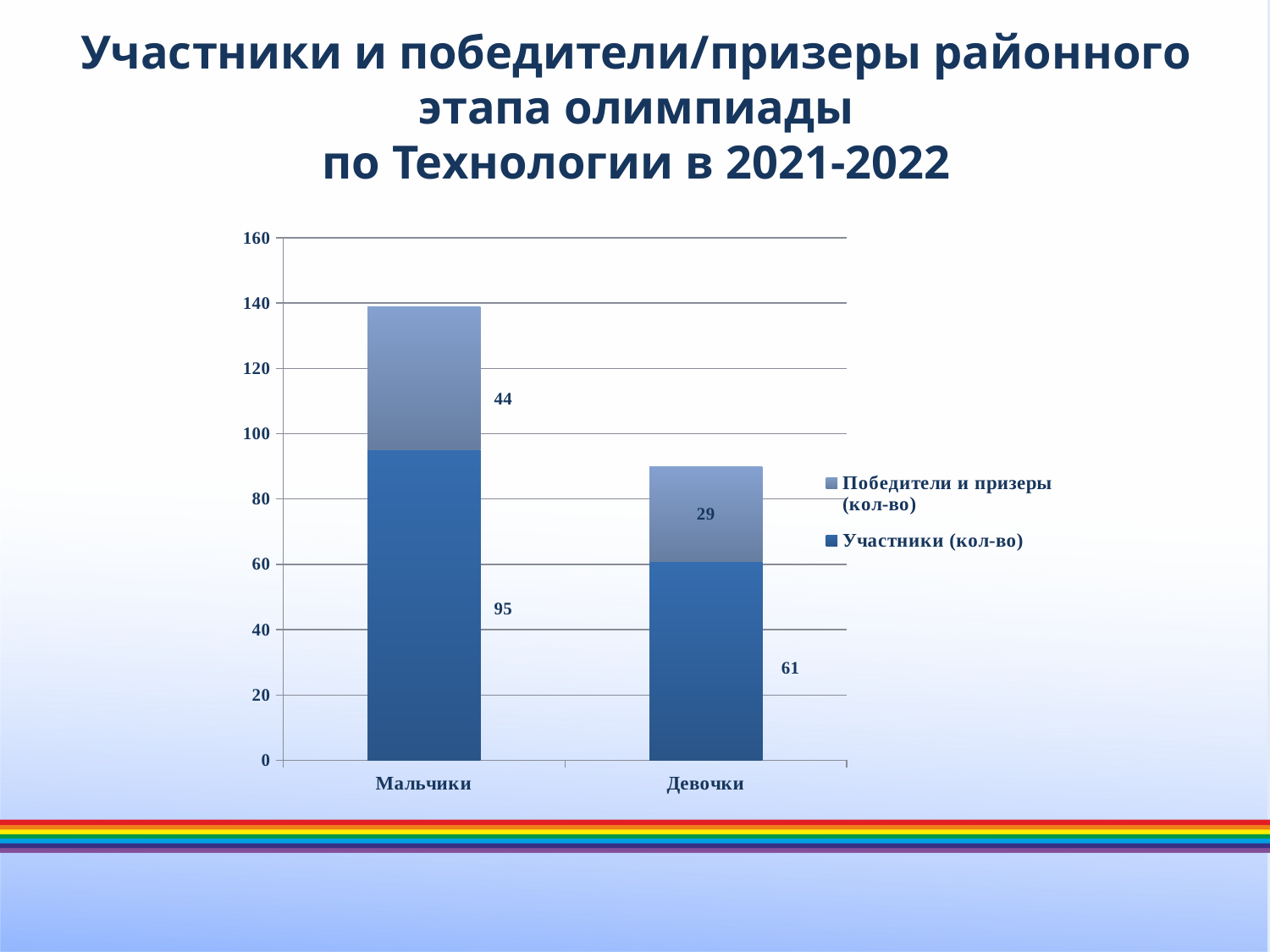
What is the value of Победители и призеры (кол-во) for Девочки? 29 What is the difference between the Участники (кол-во) values for Мальчики and Девочки? 34 What is the total of the stacked bar for Мальчики? 139 What is the value of Участники (кол-во) for Девочки? 61 What is the value of Участники (кол-во) for Мальчики? 95 How many series does the legend list? 2 Which category has the lower value for Победители и призеры (кол-во)? Девочки Is the total of the stacked bar for Мальчики greater or less than 120? greater What is the total of the stacked bar for Девочки? 90 What kind of chart is shown on the slide? stacked bar chart Which category has the higher value for Участники (кол-во)? Мальчики What is the value of Победители и призеры (кол-во) for Мальчики? 44